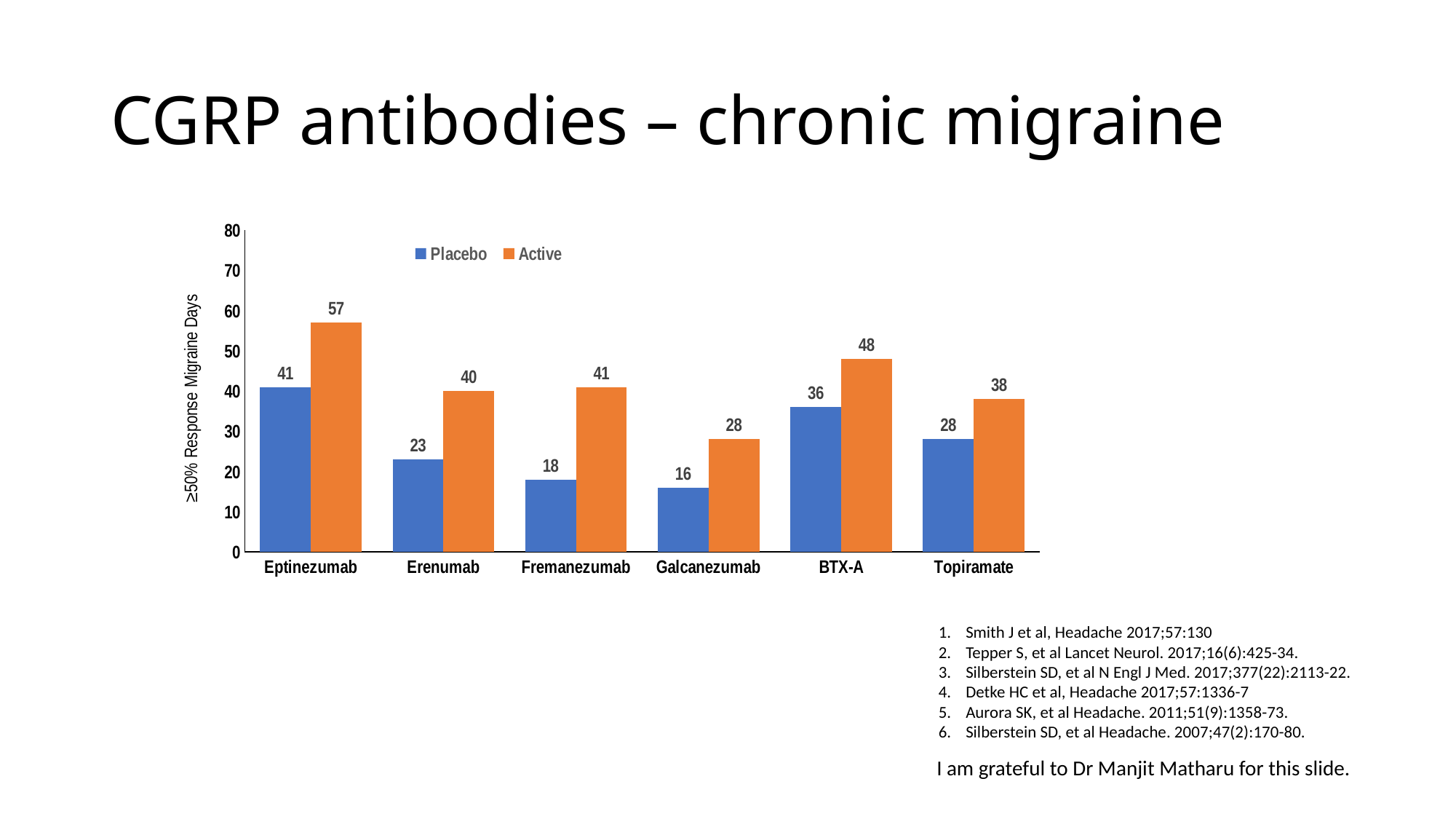
Is the Active value for Galcanezumab greater or less than 30? less Which category has the lowest Placebo value? Galcanezumab What is the Placebo value for Galcanezumab? 16 What is the Active value for BTX-A? 48 What is the label of the y axis? ≥50% Response Migraine Days What is the difference between the Active and Placebo values for Erenumab? 17 How many series does the legend list? 2 What is the Active value for Eptinezumab? 57 What kind of chart is shown on the slide? bar chart How many categories are shown on the x axis? 6 Which category has the highest Active value? Eptinezumab Which is larger, the Placebo value for BTX-A or the Placebo value for Topiramate? BTX-A